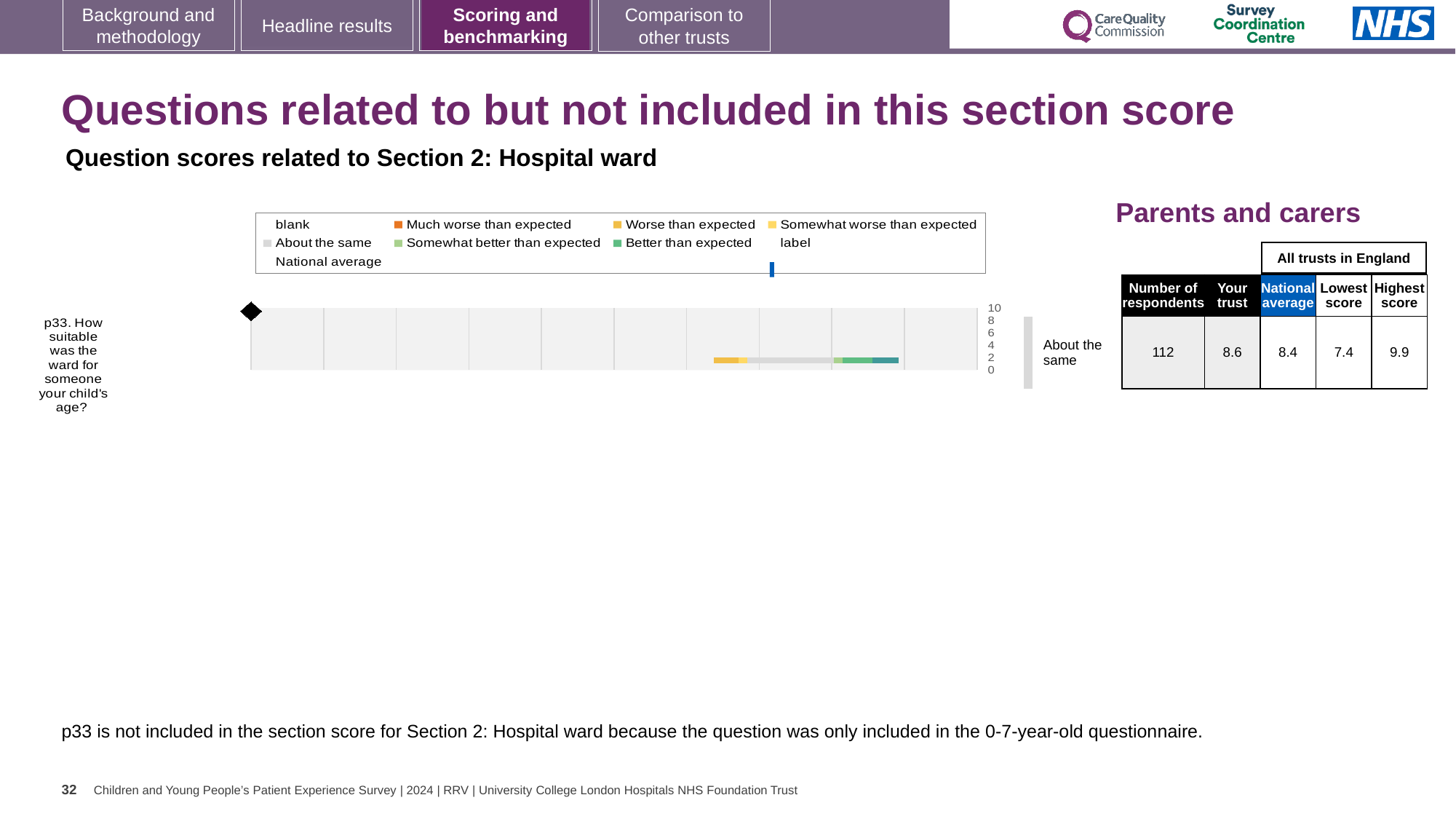
By how much does the 'Your trust' score for p33 exceed the national average? 0.2 What is the difference between the highest and lowest scores for p33? 2.5 Which question is plotted in the chart? p33. How suitable was the ward for someone your child's age? What is the 'Your trust' score for p33? 8.6 What is the highest score among all trusts in England for p33? 9.9 How many questions are plotted in the chart? 1 What benchmark category is shown next to the bar for p33? About the same How many respondents answered p33? 112 What is the lowest score among all trusts in England for p33? 7.4 What is the national average score for p33? 8.4 What kind of chart is used to show the p33 question score? bar chart Which is higher for p33, the 'Your trust' score or the national average? Your trust